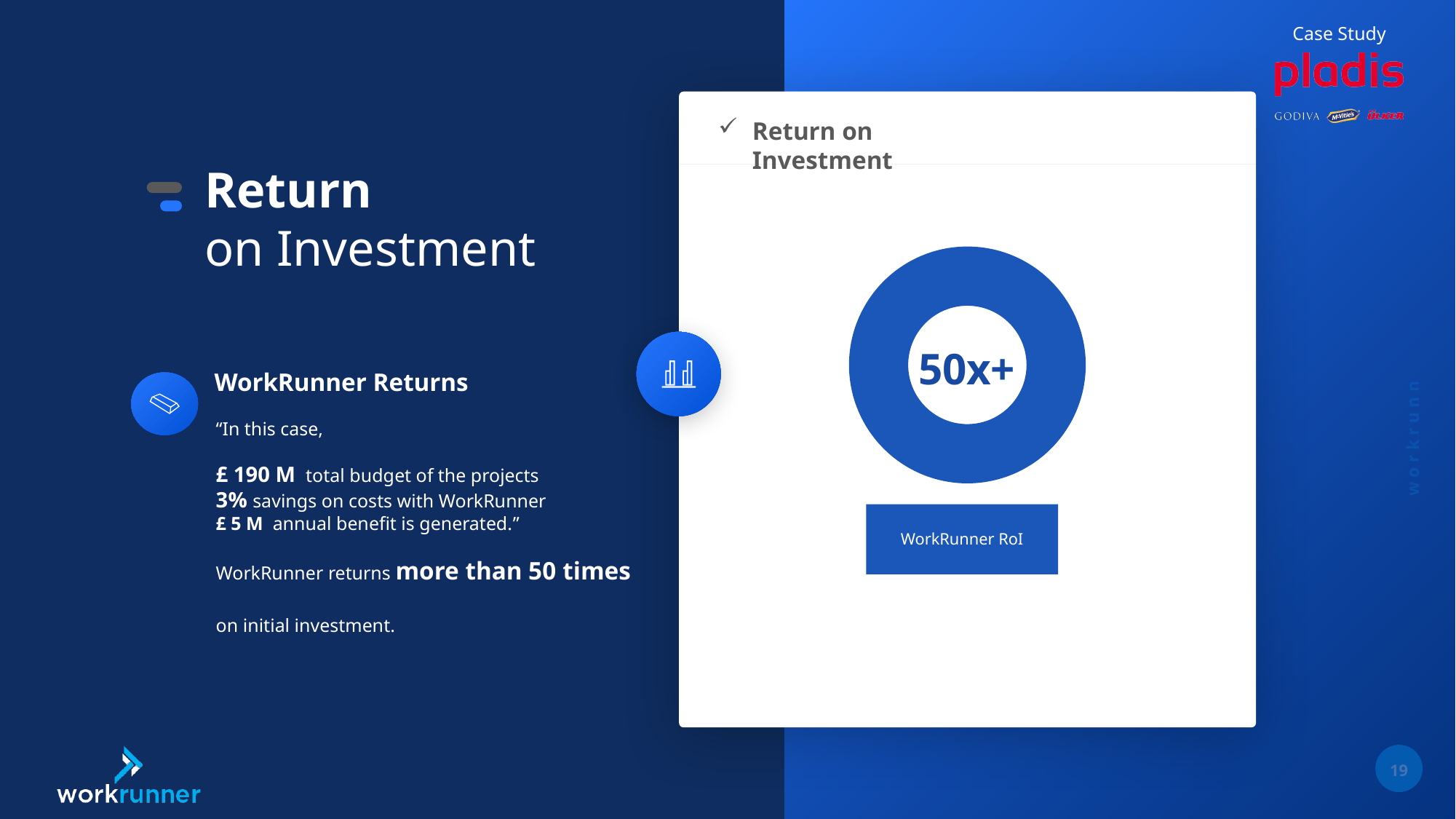
What kind of chart is shown on the slide? donut chart What is the title of the chart panel? Return on Investment What value is displayed in the centre of the donut chart? 50x+ How many series does the chart's label box list? 1 What is the label shown beneath the donut chart? WorkRunner RoI What is the WorkRunner RoI value shown in the chart? 50x+